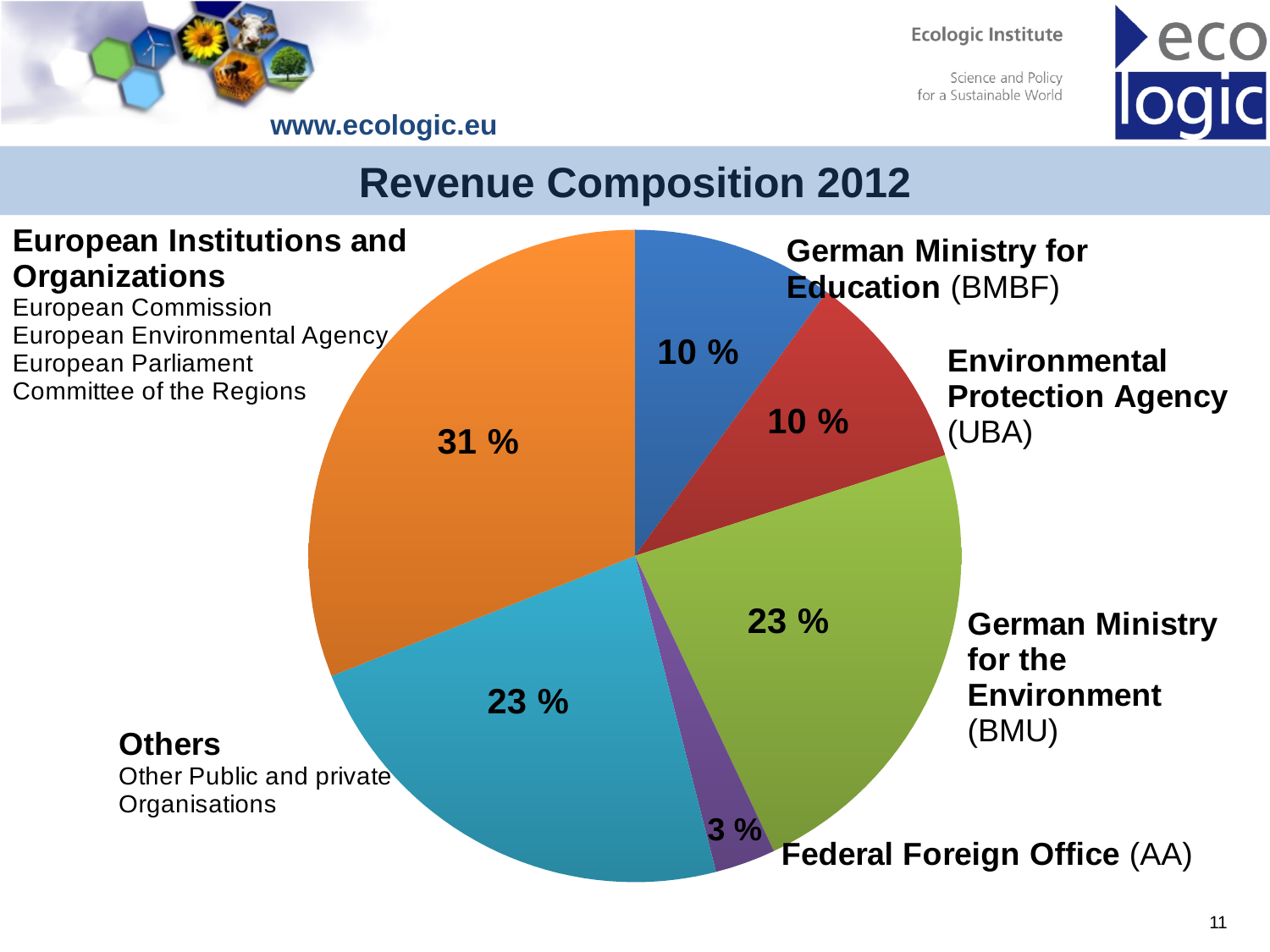
What share of revenue comes from European Institutions and Organizations? 31 % What share of revenue comes from the German Ministry for Education (BMBF)? 10 % How many slices does the pie chart have? 6 What is the title of the chart? Revenue Composition 2012 Which source accounts for the largest share of revenue? European Institutions and Organizations What share of revenue comes from the German Ministry for the Environment (BMU)? 23 % Which is larger, the share for the German Ministry for the Environment (BMU) or the share for the Environmental Protection Agency (UBA)? German Ministry for the Environment (BMU) What is the difference in percentage points between the European Institutions and Organizations share and the Others share? 8 What share of revenue comes from the Environmental Protection Agency (UBA)? 10 % What kind of chart is shown on the slide? pie chart Which source accounts for the smallest share of revenue? Federal Foreign Office (AA) What share of revenue comes from the Federal Foreign Office (AA)? 3 %